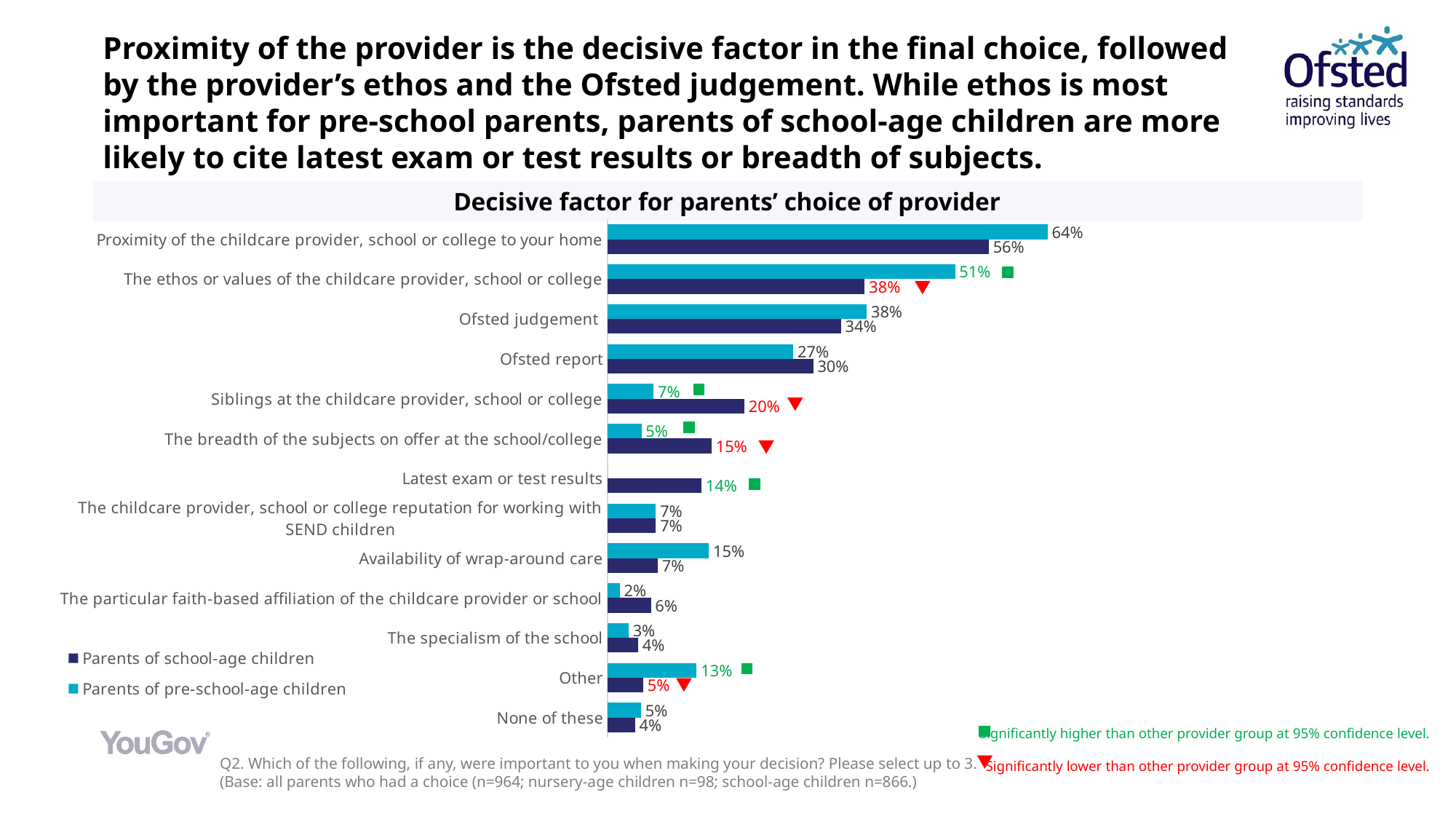
What percentage of parents of pre-school-age children cited proximity of the childcare provider, school or college to their home as a decisive factor? 64% How many series does the legend list? 2 What is the title of the chart? Decisive factor for parents' choice of provider Which factor has the highest value for parents of school-age children? Proximity of the childcare provider, school or college to your home For availability of wrap-around care, which group has the larger value? Parents of pre-school-age children What type of chart is shown on the slide? Bar chart What is the difference between parents of pre-school-age children and parents of school-age children for the ethos or values of the childcare provider, school or college? 13 percentage points For Ofsted report, which group has the larger value: parents of school-age children or parents of pre-school-age children? Parents of school-age children What percentage of parents of school-age children cited latest exam or test results? 14% What percentage of parents of school-age children cited siblings at the childcare provider, school or college? 20% How many factors (categories) are listed on the chart? 13